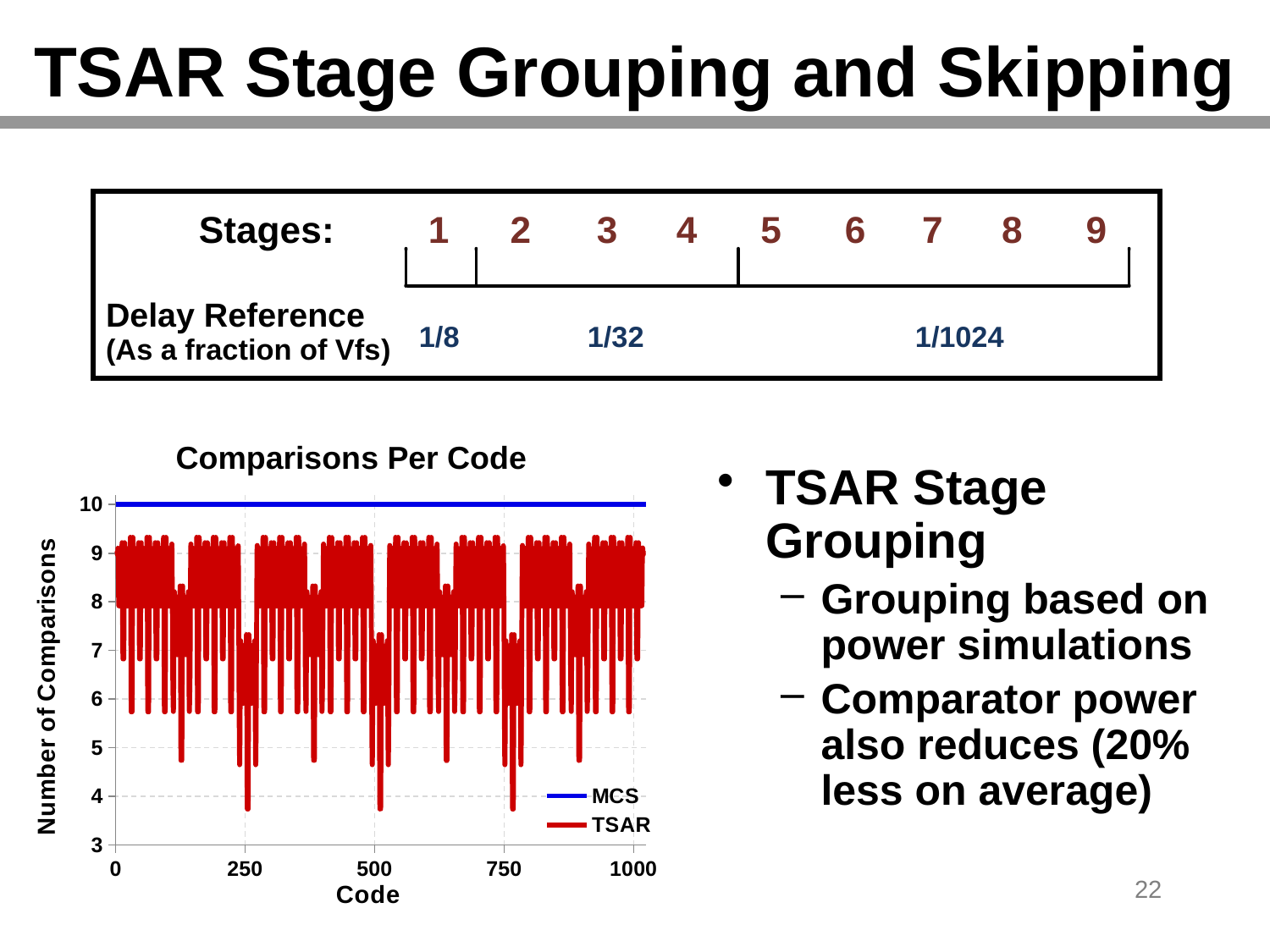
Which two series are listed in the chart legend? MCS and TSAR How many series does the chart legend list? 2 Is the lowest value of the TSAR series greater or less than 3? greater Which series has the higher number of comparisons, MCS or TSAR? MCS Does the MCS series rise, fall, or stay flat as Code increases? stays flat What is the value of the MCS series across all codes? 10 What is the label of the x axis of the chart? Code What is the title of the chart? Comparisons Per Code Is the TSAR series ever greater or less than 10 comparisons? less What kind of chart is shown on the slide? line chart